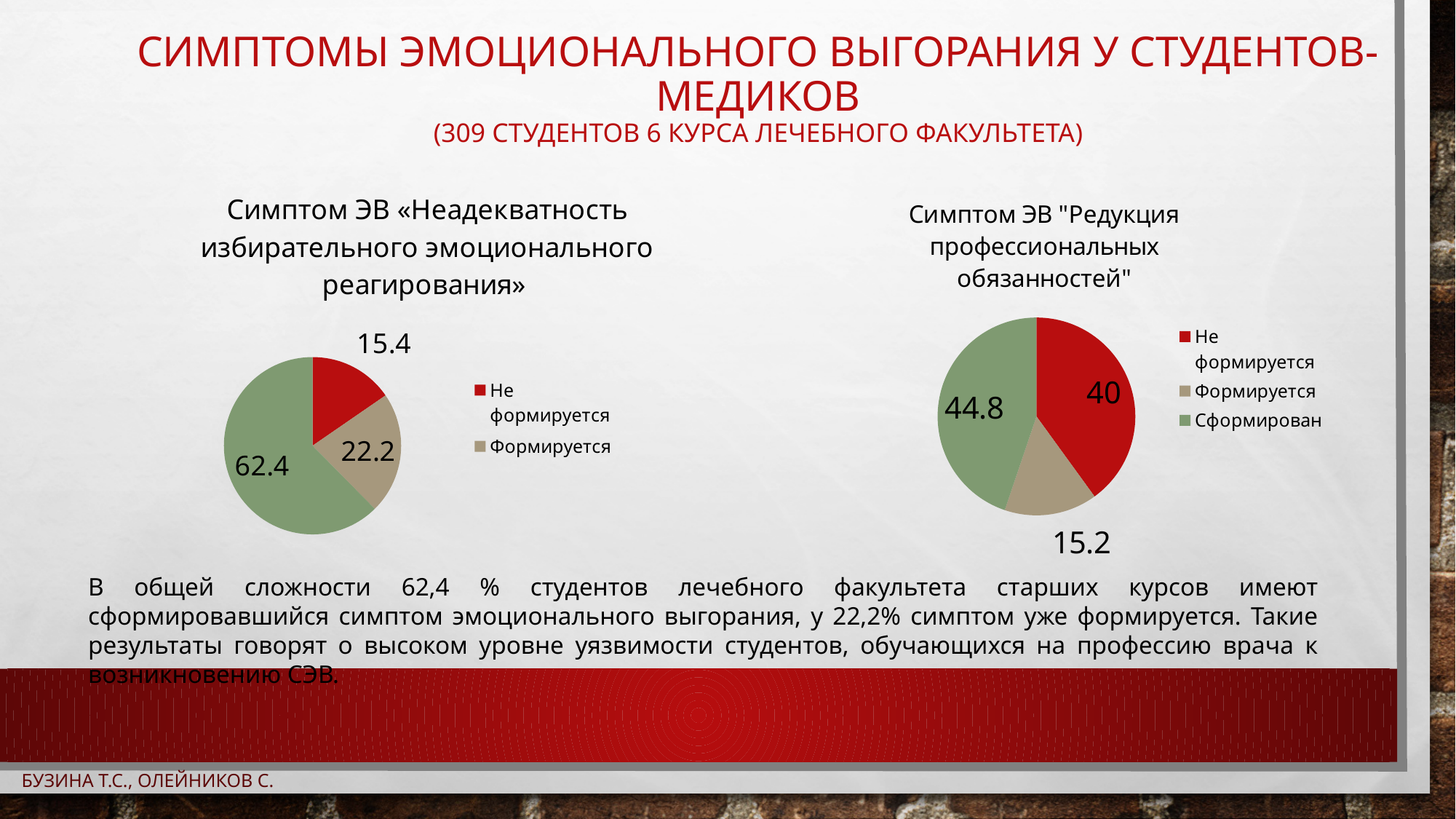
In the right pie chart (Симптом ЭВ "Редукция профессиональных обязанностей"), which category has the smallest slice? Формируется What type of chart is used for Симптом ЭВ "Редукция профессиональных обязанностей"? Pie chart In the right pie chart (Симптом ЭВ "Редукция профессиональных обязанностей"), what is the difference between the values for «Сформирован» and «Не формируется»? 4.8 In the right pie chart (Симптом ЭВ "Редукция профессиональных обязанностей"), what is the value for «Не формируется»? 40 In the right pie chart (Симптом ЭВ "Редукция профессиональных обязанностей"), which is larger: «Не формируется» or «Формируется»? Не формируется How many slices does the right pie chart (Симптом ЭВ "Редукция профессиональных обязанностей") have? 3 In the right pie chart (Симптом ЭВ "Редукция профессиональных обязанностей"), what is the value for «Сформирован»? 44.8 How many entries does the legend of the right pie chart (Симптом ЭВ "Редукция профессиональных обязанностей") list? 3 In the left pie chart (Симптом ЭВ «Неадекватность избирательного эмоционального реагирования»), what is the value for «Формируется»? 22.2 In the left pie chart (Симптом ЭВ «Неадекватность избирательного эмоционального реагирования»), what is the value for «Не формируется»? 15.4 In the left pie chart (Симптом ЭВ «Неадекватность избирательного эмоционального реагирования»), which category has the smallest slice? Не формируется In the left pie chart (Симптом ЭВ «Неадекватность избирательного эмоционального реагирования»), what is the value of the largest slice? 62.4